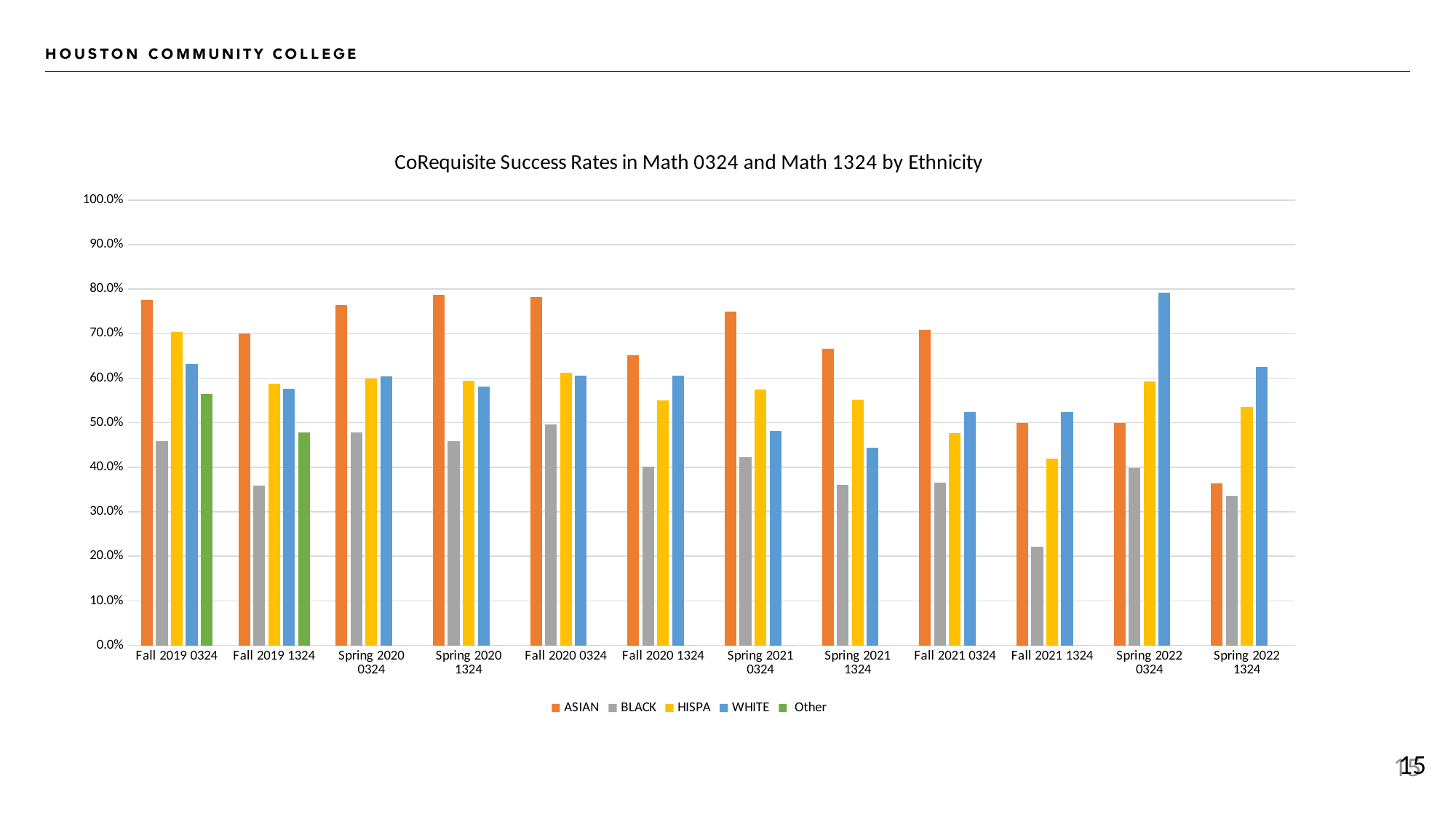
How many term/course categories are shown on the x axis? 12 Is the BLACK value for Fall 2021 1324 greater or less than 30.0%? less In Spring 2021 0324, which is larger, the HISPA value or the WHITE value? HISPA Which ethnicity has the lowest success rate in Fall 2019 0324? BLACK In Fall 2020 1324, which is larger, the WHITE value or the HISPA value? WHITE Which categories include a bar for the Other series? Fall 2019 0324 and Fall 2019 1324 Which ethnicity has the highest success rate in Spring 2022 0324? WHITE How many series does the legend list? 5 Is the ASIAN value for Fall 2019 0324 greater or less than 70.0%? greater In which category is the BLACK bar the lowest across the whole chart? Fall 2021 1324 What kind of chart is shown on the slide? Bar chart Is the WHITE value for Spring 2022 0324 greater or less than 70.0%? greater